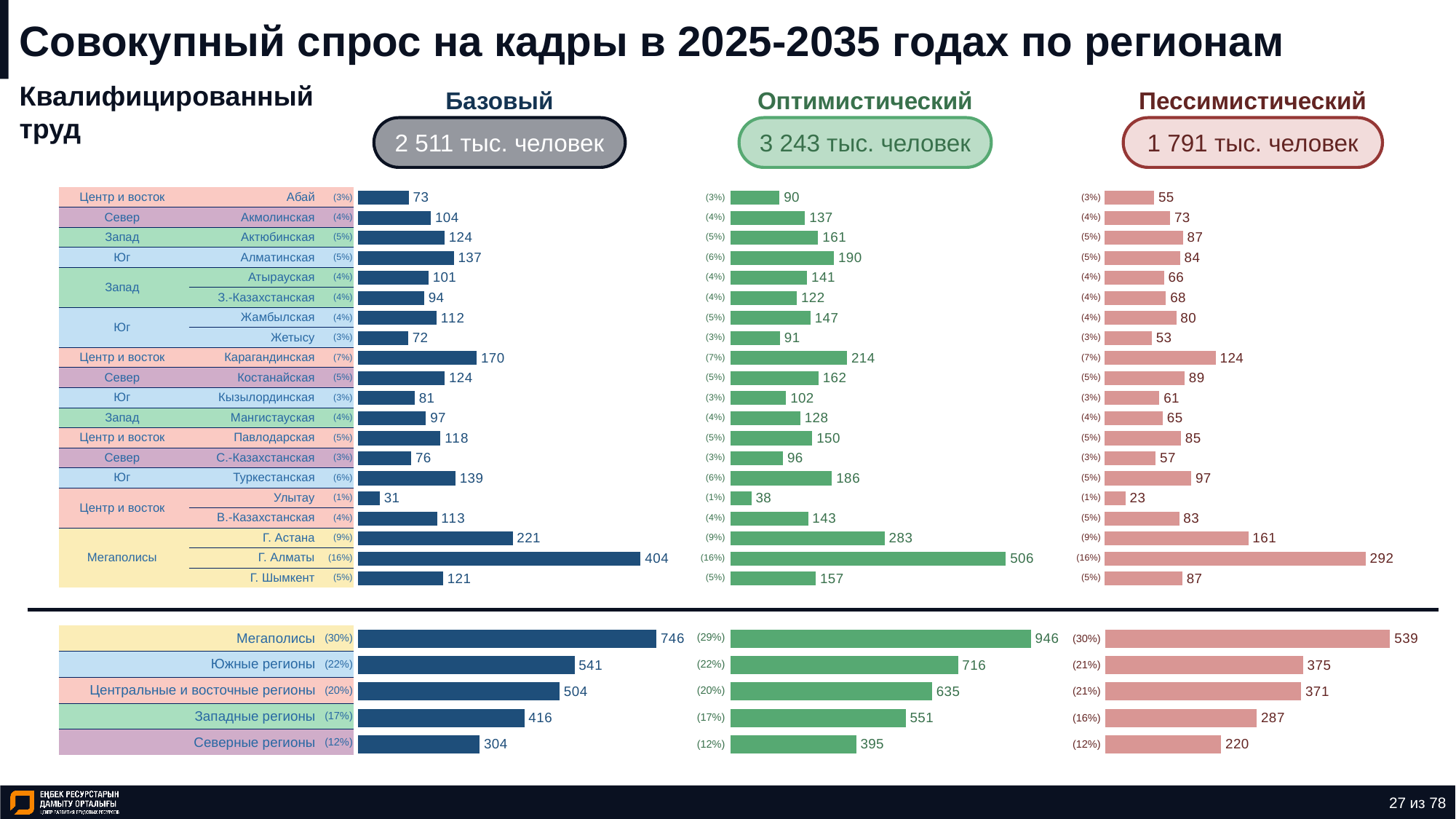
In the Пессимистический chart, what is the value for Г. Астана? 161 What total is shown in the box under the Базовый heading? 2 511 тыс. человек In the Базовый chart, which region has the highest value? Г. Алматы In the bottom summary section, how many macro-region categories are shown? 5 In the Базовый chart, what is the value for Г. Алматы? 404 In the bottom summary of the Оптимистический chart, what is the value for Южные регионы? 716 What type of chart is used on this slide? Bar chart In the bottom summary of the Пессимистический chart, what is the difference between Мегаполисы and Северные регионы? 319 In the Базовый chart, what is the difference between the values for Г. Астана and Г. Шымкент? 100 In the Оптимистический chart, what is the value for Карагандинская? 214 In the Оптимистический chart, which region has the lowest value? Улытау In the Базовый chart, which is larger: the value for Карагандинская or for Павлодарская? Карагандинская